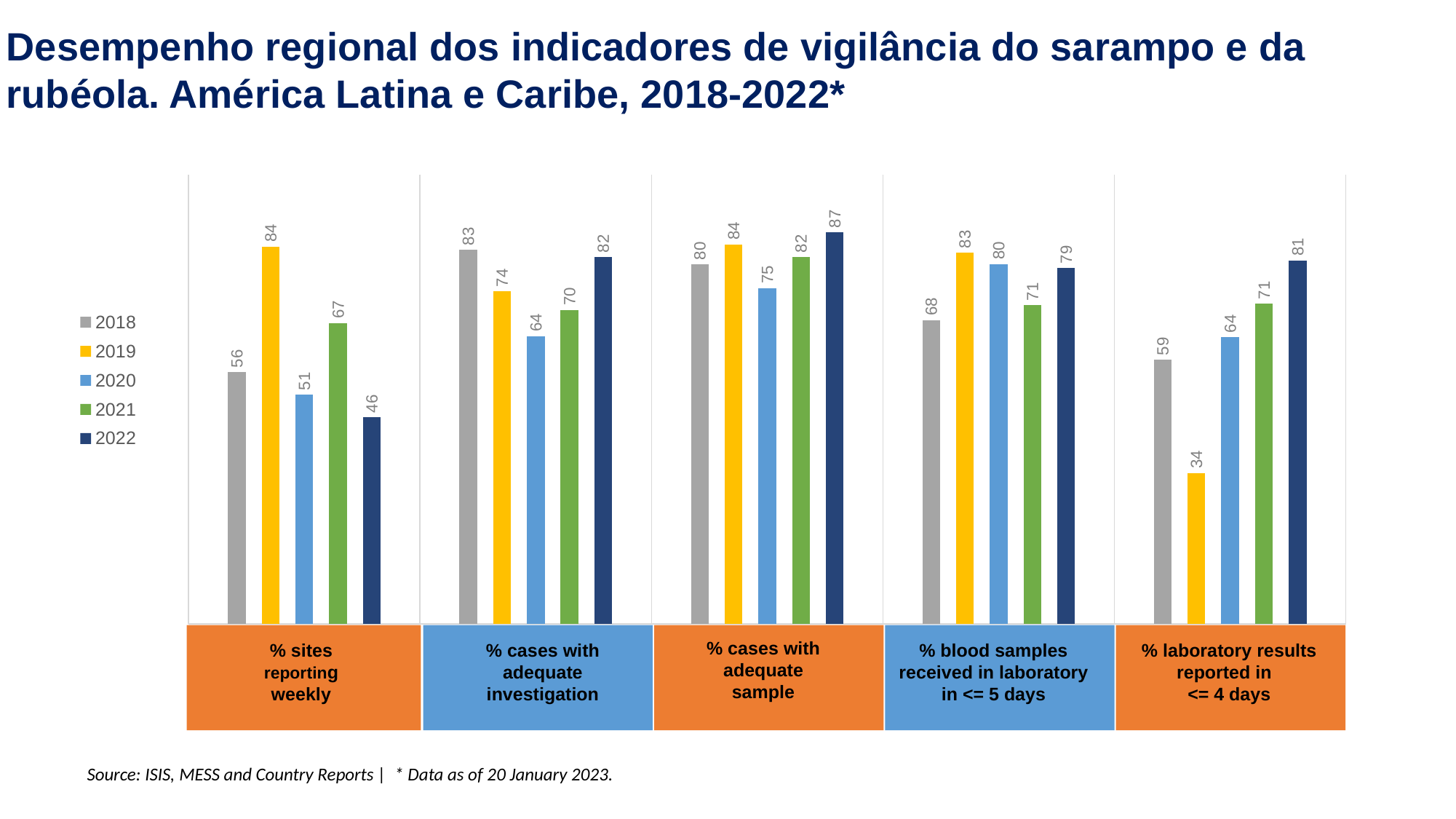
What kind of chart is shown on the slide? Bar chart What is the difference between the 2018 and 2020 values in the '% cases with adequate investigation' category? 19 What is the value for 2022 in the '% cases with adequate sample' category? 87 What is the value for 2019 in the '% laboratory results reported in <= 4 days' category? 34 What is the value for 2019 in the '% sites reporting weekly' category? 84 Which is larger in the '% blood samples received in laboratory in <= 5 days' category: the 2019 value or the 2021 value? 2019 How many series does the legend list? 5 Which year has the highest value in the '% cases with adequate investigation' category? 2018 Which year has the lowest value in the '% sites reporting weekly' category? 2022 Which colour represents the 2021 series in the legend? Green What is the difference between the 2022 and 2019 values in the '% laboratory results reported in <= 4 days' category? 47 How many indicator categories are shown on the x axis? 5